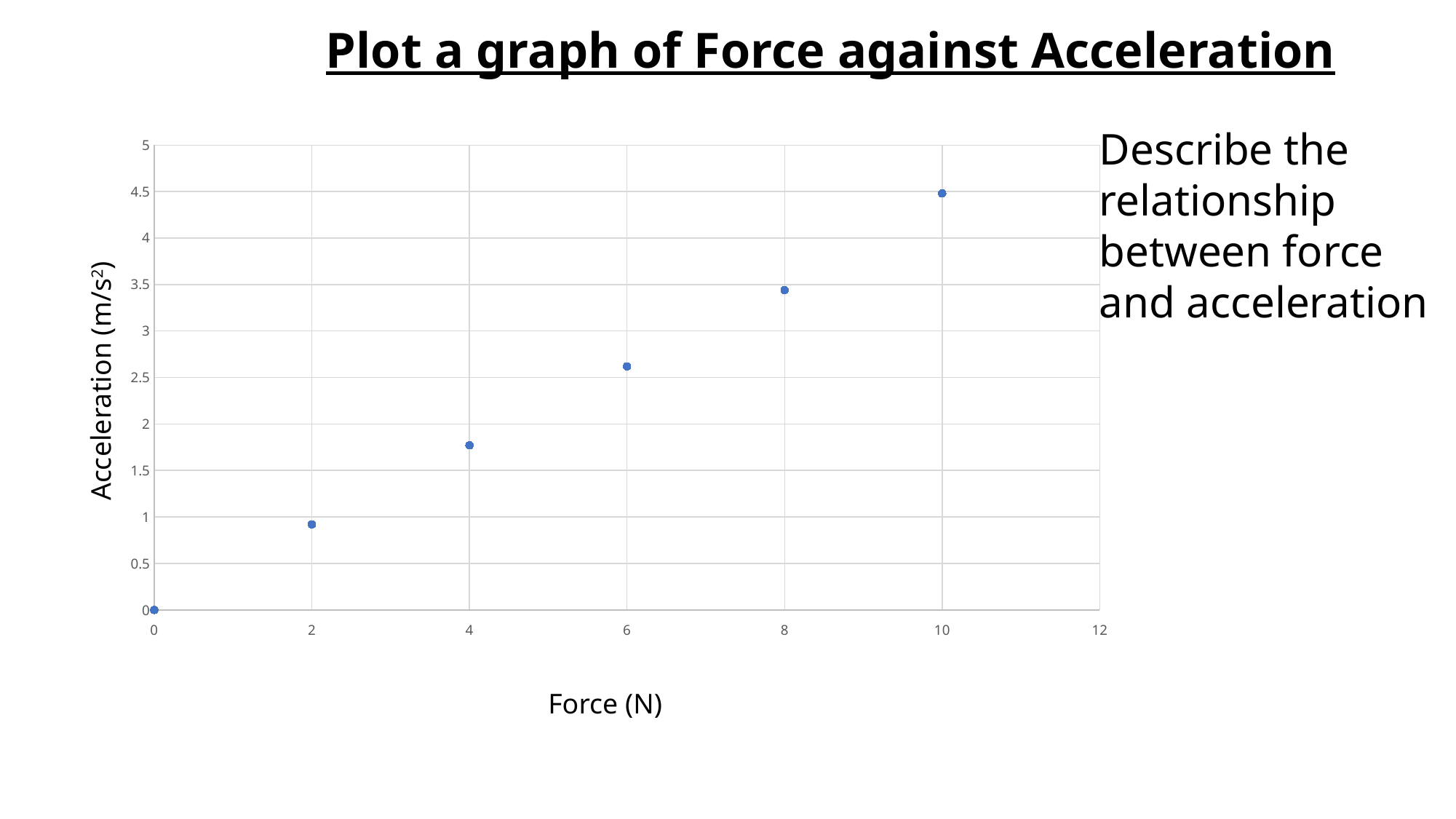
How many data points are plotted on the chart? 6 At which force value is the acceleration highest? 10 Is the acceleration at a force of 10 N greater or less than 4? greater Is the acceleration at a force of 4 N greater or less than 1.5? greater Is the acceleration at a force of 6 N greater or less than 2.5? greater Which has the larger acceleration: a force of 6 N or a force of 8 N? 8 N Does acceleration rise or fall as force increases along the x axis? rise What is the acceleration when the force is 0 N? 0 At which force value is the acceleration lowest? 0 What kind of chart is shown on the slide? scatter plot